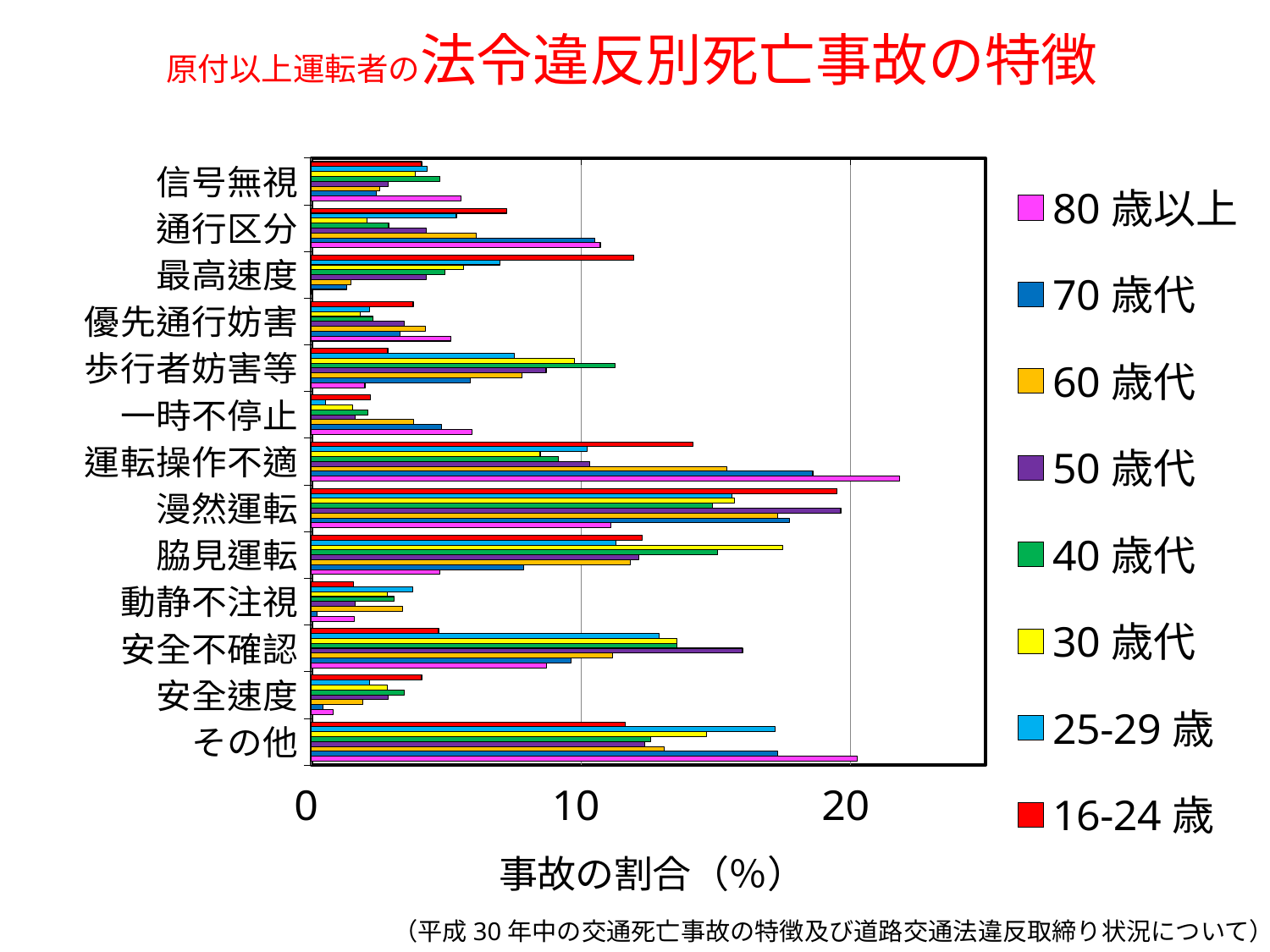
What kind of chart is shown on the slide? bar chart Which age group has the highest value in the 最高速度 category? 16-24歳 What is the title of the horizontal axis? 事故の割合（%） Which age group has the lowest value in the 漫然運転 category? 80歳以上 How many violation categories are shown on the vertical axis? 13 How many age-group series does the legend list? 8 Is the value for 50歳代 in the 安全不確認 category greater or less than 10? greater Is the value for 80歳以上 in the 安全速度 category greater or less than 10? less Is the value for 80歳以上 in the 運転操作不適 category greater or less than 20? greater Which age group has the highest value in the 運転操作不適 category? 80歳以上 In the 最高速度 category, which is larger: the value for 16-24歳 or the value for 80歳以上? 16-24歳